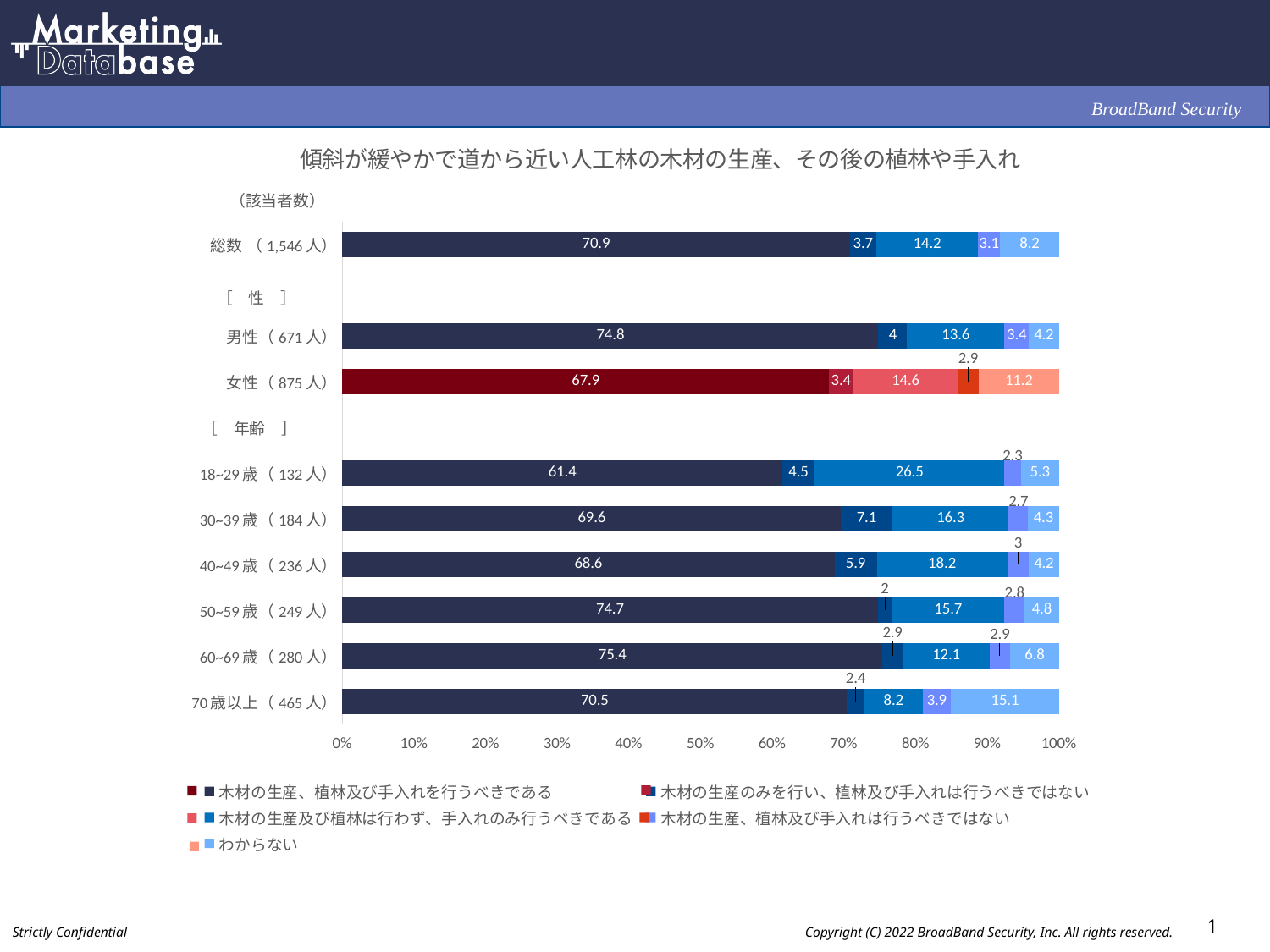
Which is larger for 「わからない」: 女性 (875人) or 男性 (671人)? 女性 (875人) What is the value of 「わからない」 for 70歳以上 (465人)? 15.1 How many series does the legend list? 5 What is the difference between 男性 (671人) and 女性 (875人) for 「木材の生産、植林及び手入れを行うべきである」? 6.9 Which category has the highest value for 「木材の生産、植林及び手入れを行うべきである」? 60~69歳 (280人) What kind of chart is shown on the slide? Stacked bar chart Is the value of 「木材の生産、植林及び手入れを行うべきである」 for 50~59歳 (249人) greater or less than 70%? greater Which category has the lowest value for 「木材の生産、植林及び手入れを行うべきである」? 18~29歳 (132人) What is the title of the chart? 傾斜が緩やかで道から近い人工林の木材の生産、その後の植林や手入れ What is the value of 「木材の生産、植林及び手入れを行うべきである」 for 総数 (1,546人)? 70.9 What is the value of 「木材の生産及び植林は行わず、手入れのみ行うべきである」 for 18~29歳 (132人)? 26.5 How many respondent categories (bars) are plotted in the chart? 9